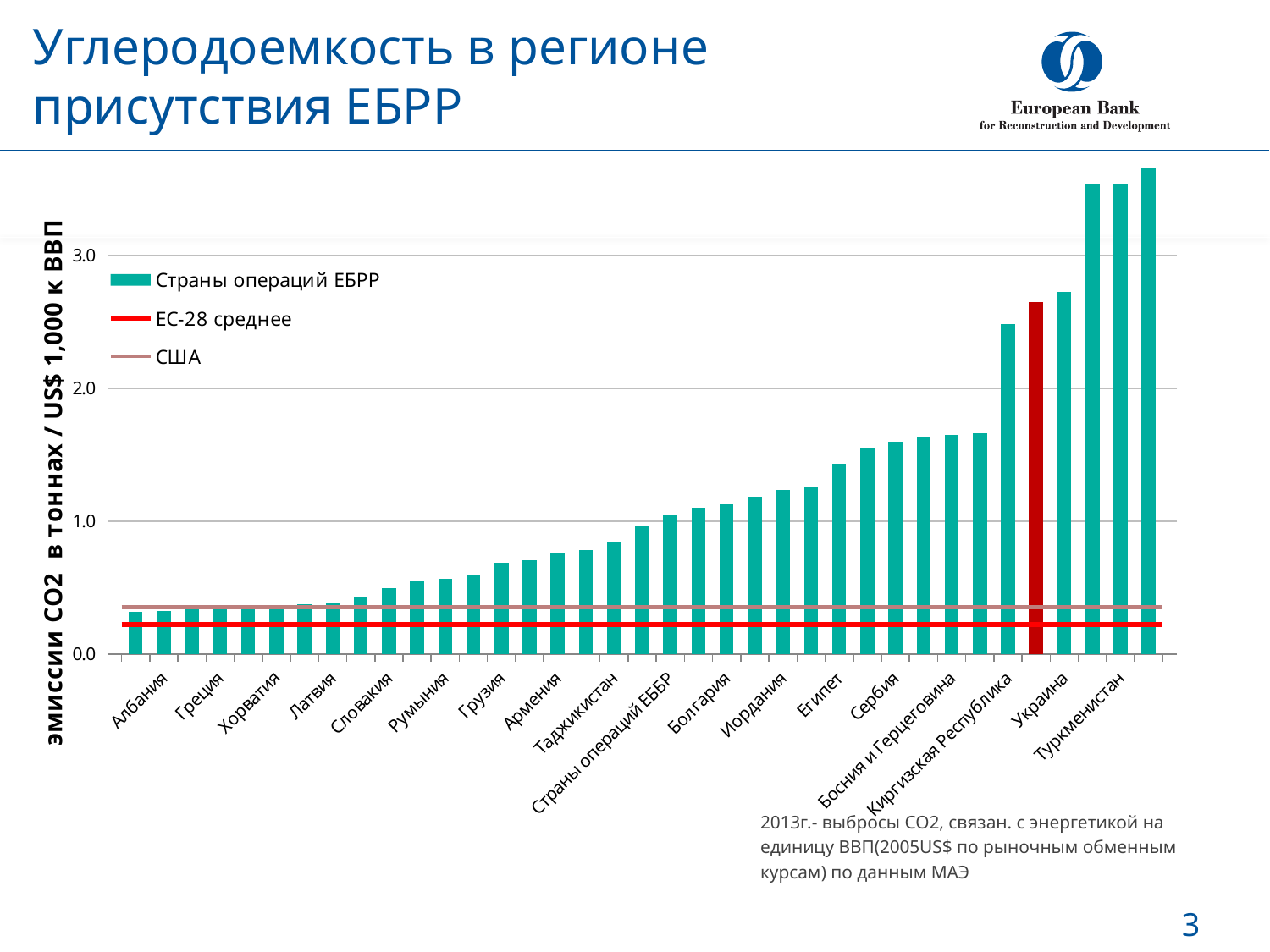
Is the value for Грузия greater or less than 1.0? less Which has the larger value, Украина or Греция? Украина Is the value for Киргизская Республика greater or less than 2.0? greater Do the bar values rise or fall from left to right along the x axis? rise Is the value for Туркменистан greater or less than 3.0? greater What kind of chart is shown on the slide? bar chart Which legend entry is shown with a red line? ЕС-28 среднее Which has the larger value, Туркменистан or Албания? Туркменистан How many series does the legend list? 3